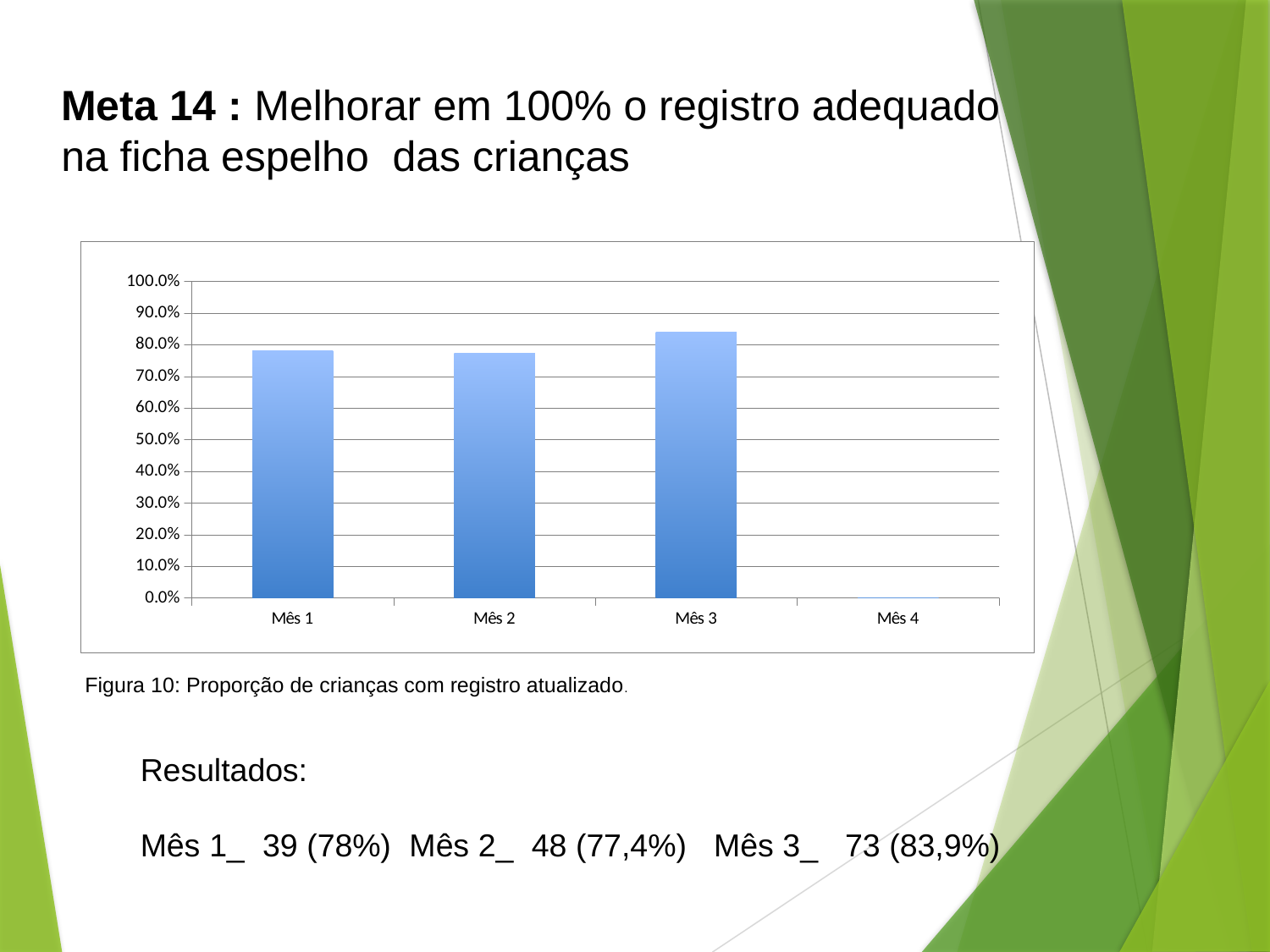
Which month has the highest bar? Mês 3 Which month has the lowest bar? Mês 4 How many months are shown on the x axis? 4 What is the difference between the values for Mês 3 and Mês 1? 5,9 percentage points What is the value for Mês 2? 77,4% What is the caption of the figure below the chart? Figura 10: Proporção de crianças com registro atualizado Is the value for Mês 3 greater or less than 80.0%? greater Is the value for Mês 1 greater or less than 70.0%? greater What is the value for Mês 1? 78% What is the value for Mês 3? 83,9% What kind of chart is shown? Bar chart Is the value for Mês 2 greater or less than 80.0%? less